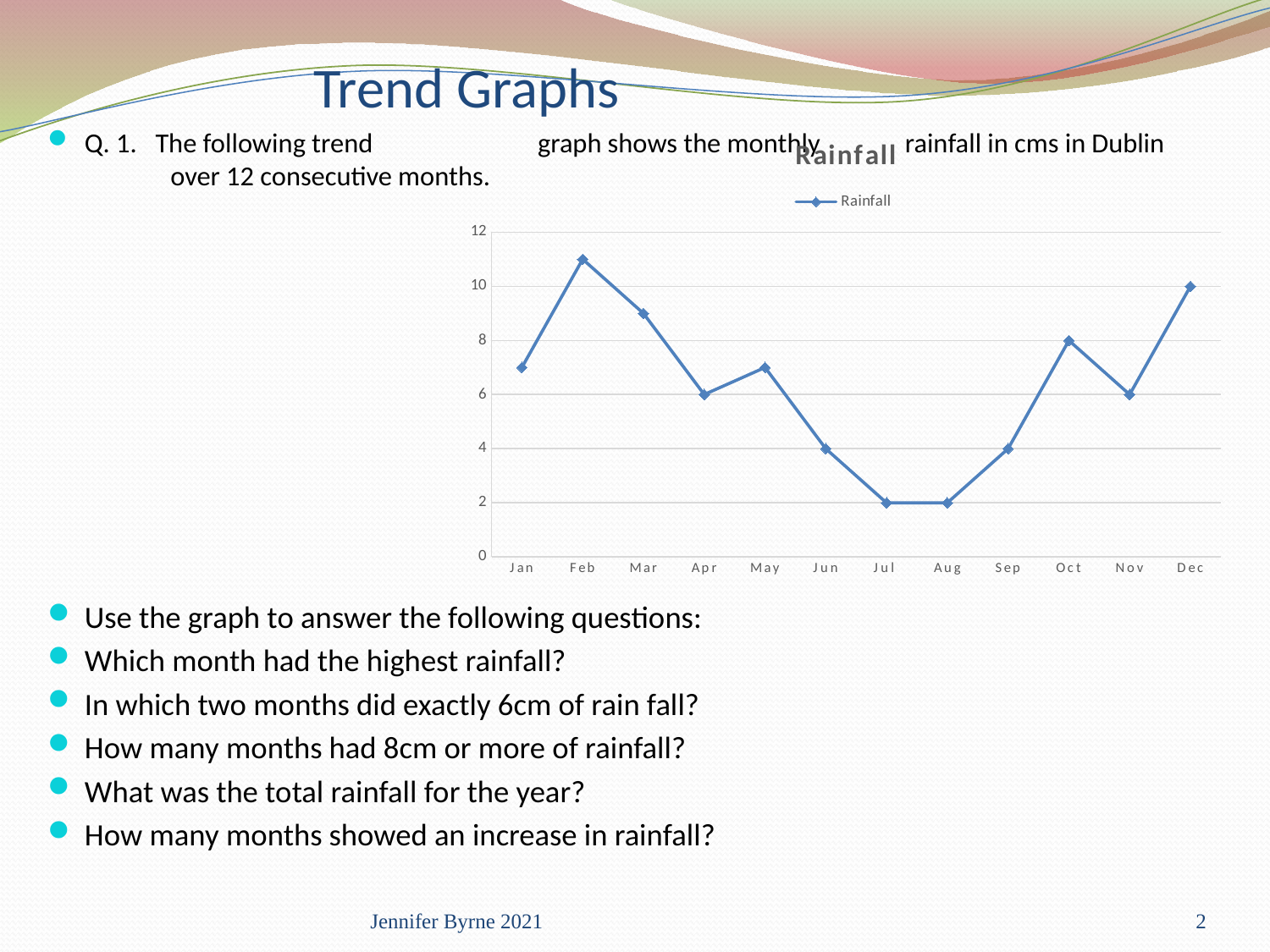
What is the rainfall value for Dec? 10 How many series does the legend list? 1 How many months are plotted on the x axis? 12 What is the rainfall value for Oct? 8 Which month has the highest rainfall value? Feb Is the value for Feb greater or less than 10? greater What kind of chart is shown on the slide? line chart Does the rainfall rise or fall from Feb to Apr? fall What is the difference between the rainfall values for Dec and Oct? 2 What is the title of the chart? Rainfall What is the rainfall value for Jul? 2 Which is larger, the rainfall value for Oct or for Nov? Oct